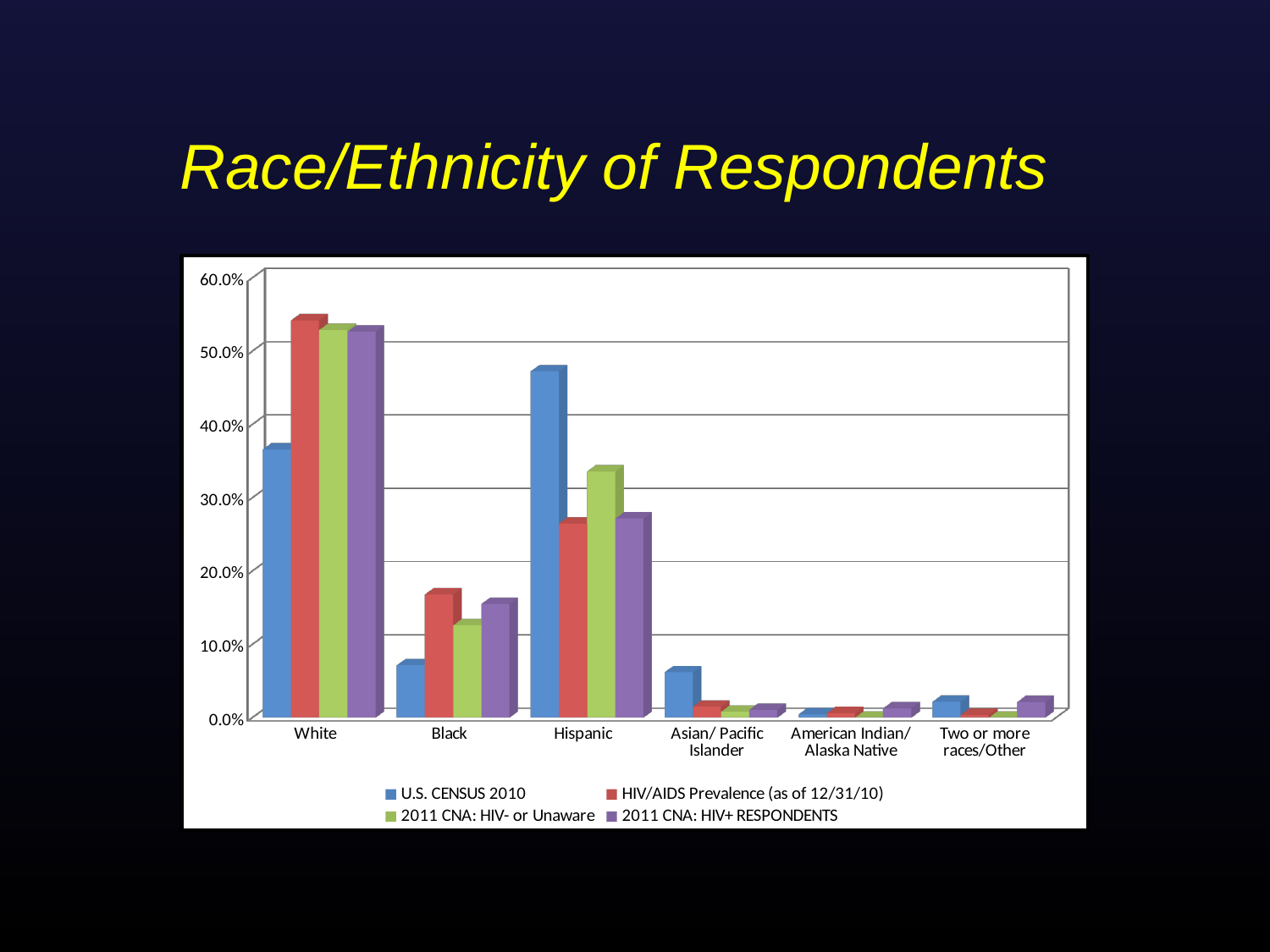
How many race/ethnicity categories are shown on the x axis? 6 Is the HIV/AIDS Prevalence (as of 12/31/10) value for White greater or less than 50.0%? greater Which category has the highest U.S. CENSUS 2010 value? Hispanic For Black, which is larger: the U.S. CENSUS 2010 value or the HIV/AIDS Prevalence (as of 12/31/10) value? HIV/AIDS Prevalence (as of 12/31/10) For Hispanic, which is larger: the U.S. CENSUS 2010 value or the 2011 CNA: HIV- or Unaware value? U.S. CENSUS 2010 Is the 2011 CNA: HIV- or Unaware value for Hispanic greater or less than 30.0%? greater How many series does the legend list? 4 Is the U.S. CENSUS 2010 value for Hispanic greater or less than 40.0%? greater What kind of chart is shown on the slide? bar chart Which category has the highest HIV/AIDS Prevalence (as of 12/31/10) value? White What is the title of the slide containing the chart? Race/Ethnicity of Respondents